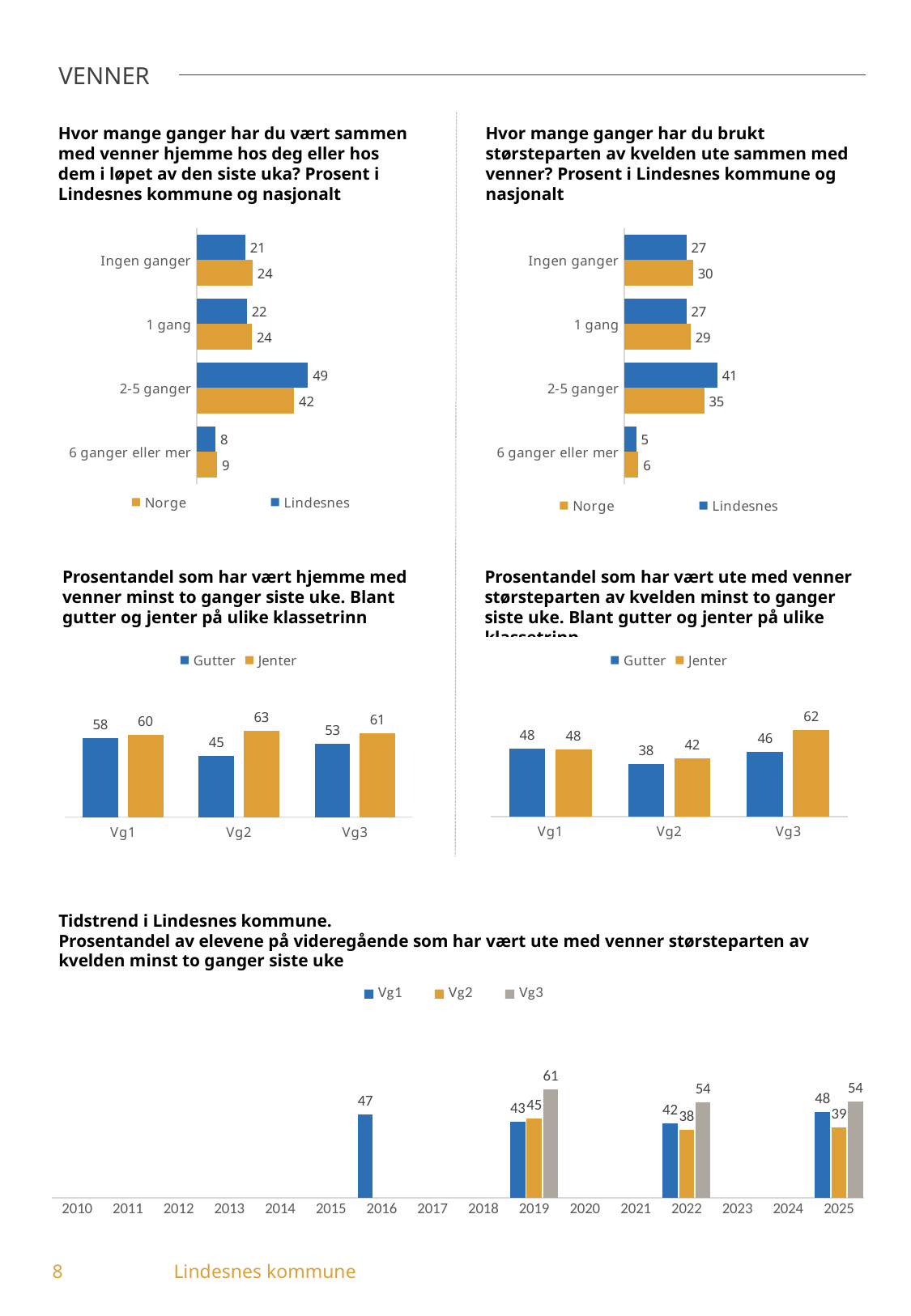
In the bottom chart (Tidstrend i Lindesnes kommune), how many series does the legend list? 3 In the top-right chart (evenings out with friends), how many series does the legend list? 2 In the bottom chart (Tidstrend i Lindesnes kommune), what is the value for Vg3 in 2019? 61 In the top-left chart (times together with friends at home), what is the difference between Norge and Lindesnes for 'Ingen ganger'? 3 In the middle-right chart (out with friends at least twice, by gender and grade), which is larger in Vg2: Gutter or Jenter? Jenter In the top-right chart (evenings out with friends), which category has the lowest value for Lindesnes? 6 ganger eller mer In the middle-left chart (home with friends at least twice, by gender and grade), what is the value for Jenter in Vg2? 63 In the middle-left chart (home with friends at least twice, by gender and grade), which group has the lowest value? Gutter in Vg2 In the top-left chart (times together with friends at home), what is the value for Lindesnes in the '2-5 ganger' category? 49 In the middle-right chart (out with friends at least twice, by gender and grade), what is the difference between Jenter and Gutter in Vg3? 16 In the top-right chart (evenings out with friends), what is the value for Norge in the '1 gang' category? 29 What kind of chart is the bottom chart (Tidstrend i Lindesnes kommune)? Bar chart